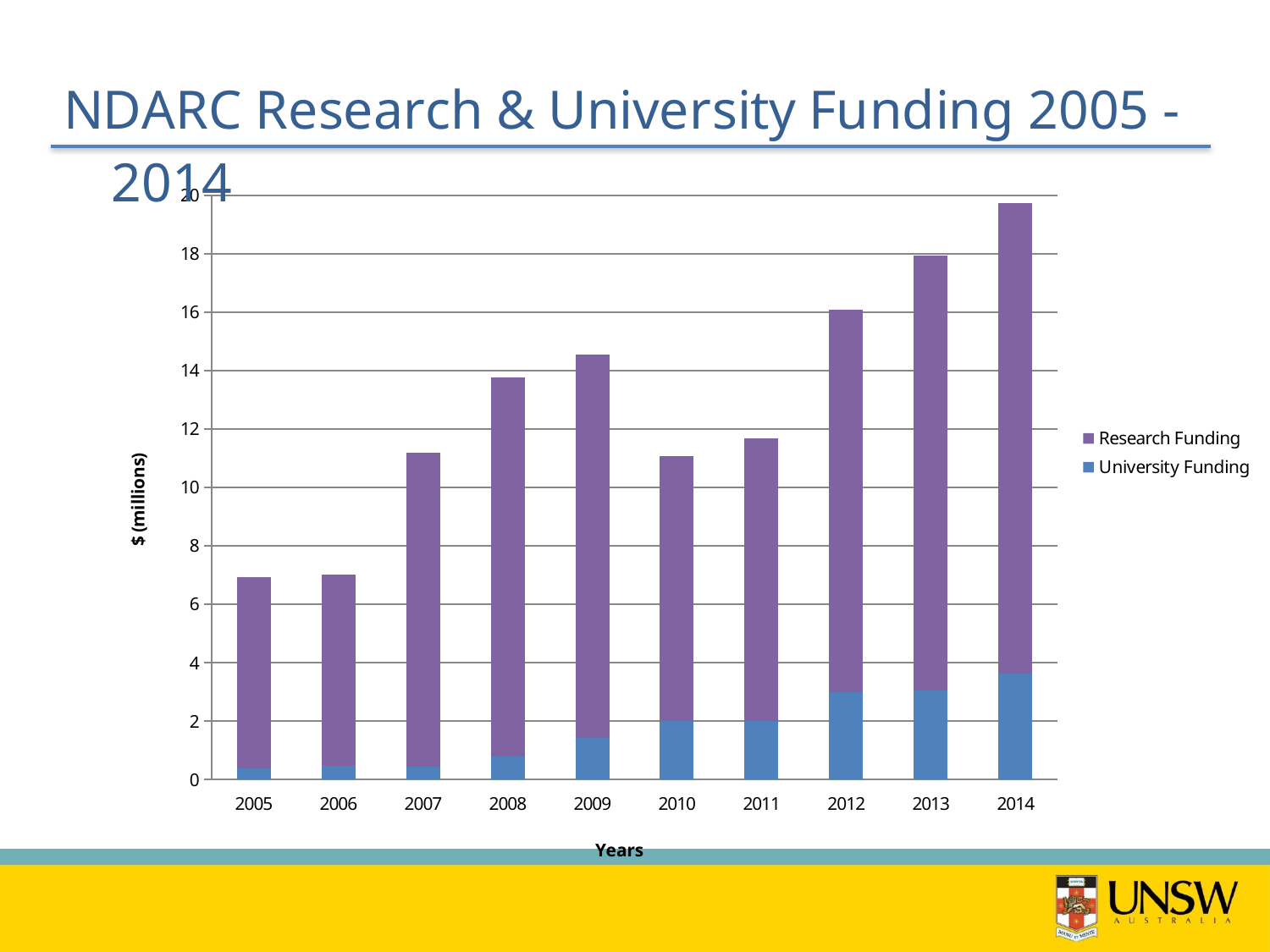
Do the total funding values generally rise or fall from 2005 to 2014? rise Is the total funding for 2010 greater or less than 12? less Which year has the highest total funding? 2014 Is the total funding for 2014 greater or less than 18? greater What kind of chart is shown on the slide? Stacked bar chart Is the University Funding value for 2014 greater or less than 2? greater Which year has the larger total funding, 2009 or 2010? 2009 How many series does the chart's legend list? 2 How many years are shown on the x axis of the chart? 10 What is the label on the vertical axis of the chart? $ (millions) Which year has the larger University Funding value, 2013 or 2010? 2013